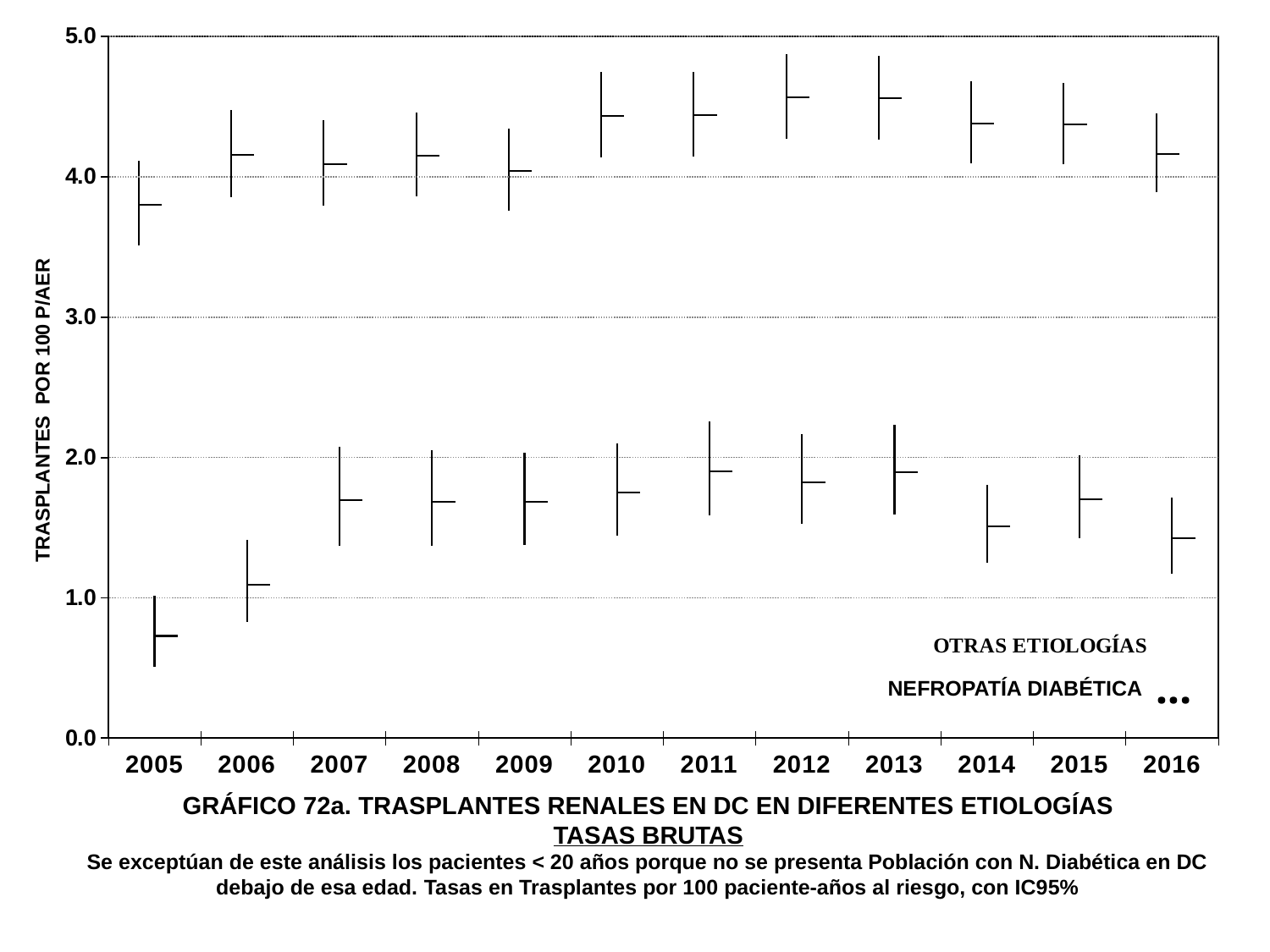
For OTRAS ETIOLOGÍAS, which year has the larger value, 2005 or 2010? 2010 Do the values for NEFROPATÍA DIABÉTICA rise or fall from 2013 to 2016? fall How many series does the legend list? 2 Is the value for OTRAS ETIOLOGÍAS in 2012 greater or less than 4.0? greater How many years are shown on the x axis of the chart? 12 For NEFROPATÍA DIABÉTICA, which year has the larger value, 2013 or 2014? 2013 Is the value for NEFROPATÍA DIABÉTICA in 2016 greater or less than 1.0? greater What is the label on the y axis of the chart? TRASPLANTES POR 100 P/AER Which year has the lowest value for OTRAS ETIOLOGÍAS? 2005 Which year has the lowest value for NEFROPATÍA DIABÉTICA? 2005 Is the value for NEFROPATÍA DIABÉTICA in 2005 greater or less than 1.0? less